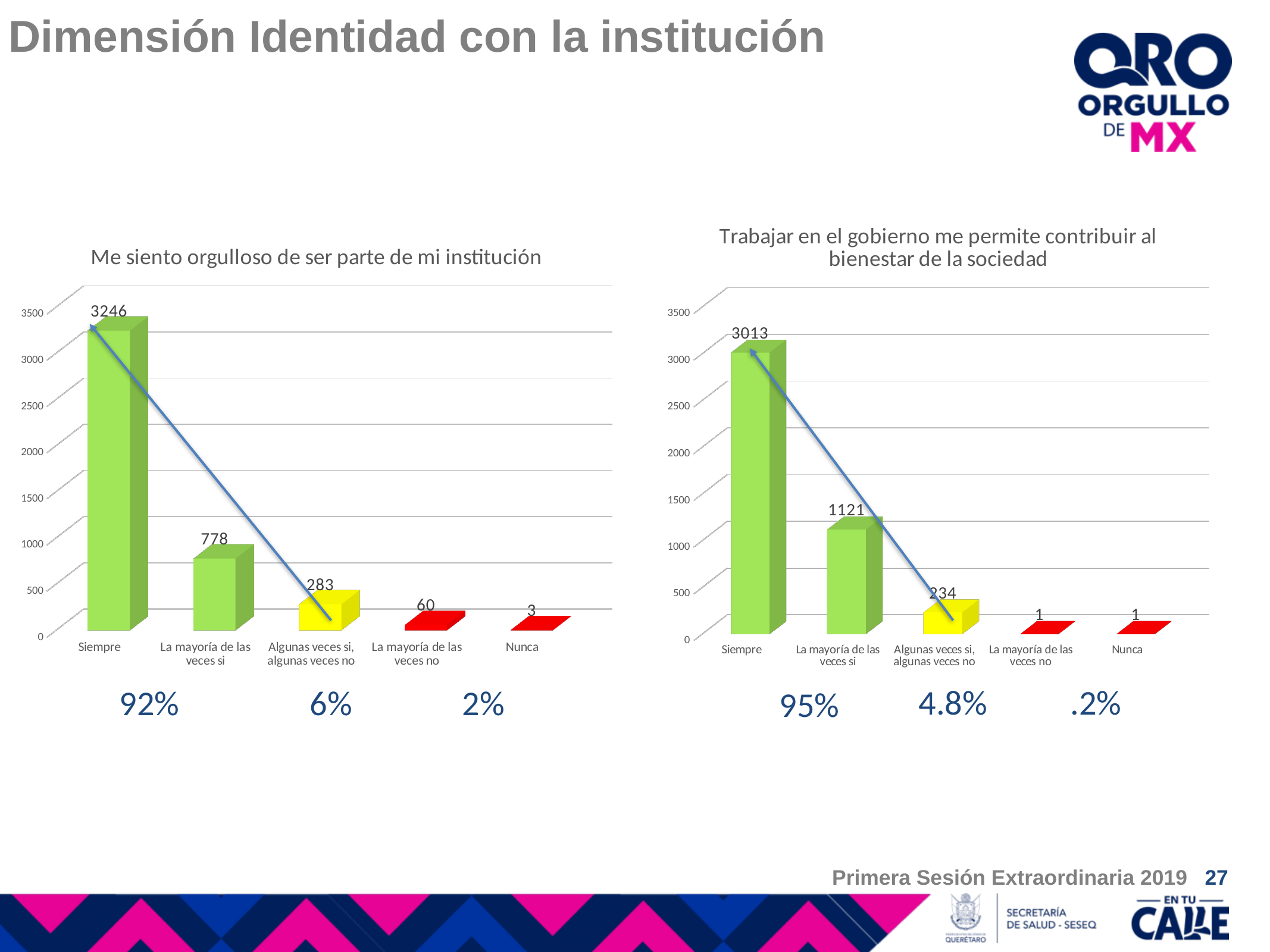
Which is larger: the Siempre value in the left chart or the Siempre value in the right chart? The left chart (3246) In the chart titled "Trabajar en el gobierno me permite contribuir al bienestar de la sociedad", what is the value for Siempre? 3013 What kind of chart is the chart titled "Trabajar en el gobierno me permite contribuir al bienestar de la sociedad"? Bar chart In the chart titled "Trabajar en el gobierno me permite contribuir al bienestar de la sociedad", what is the value for Algunas veces si, algunas veces no? 234 In the chart titled "Me siento orgulloso de ser parte de mi institución", which category has the lowest value? Nunca In the chart titled "Trabajar en el gobierno me permite contribuir al bienestar de la sociedad", which category has the highest value? Siempre In the chart titled "Trabajar en el gobierno me permite contribuir al bienestar de la sociedad", what is the difference between La mayoría de las veces si and Algunas veces si, algunas veces no? 887 In the chart titled "Me siento orgulloso de ser parte de mi institución", what is the value for Nunca? 3 How many categories are shown on the x axis of the chart titled "Me siento orgulloso de ser parte de mi institución"? 5 In the chart titled "Me siento orgulloso de ser parte de mi institución", what is the difference between Siempre and La mayoría de las veces si? 2468 In the chart titled "Me siento orgulloso de ser parte de mi institución", what is the value for La mayoría de las veces si? 778 In the chart titled "Me siento orgulloso de ser parte de mi institución", what is the value for Siempre? 3246